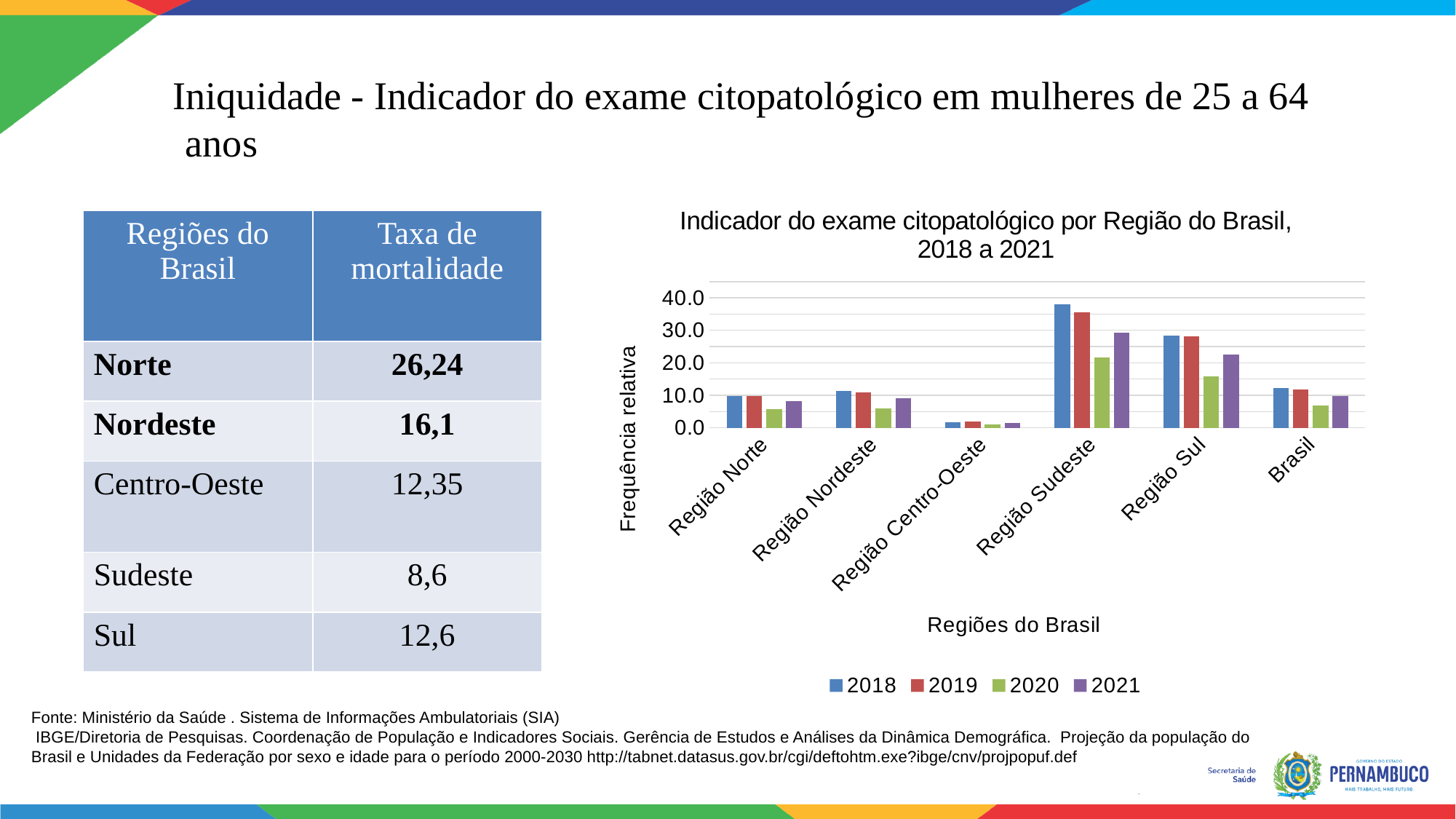
What kind of chart is shown on the slide? Bar chart Is the 2018 value for Região Norte greater or less than 20.0? less Which region has the highest value for 2018 in the chart? Região Sudeste What is the label of the chart's vertical axis? Frequência relativa Which is larger in 2018: the value for Região Sudeste or the value for Região Sul? Região Sudeste For Região Sudeste, is the 2020 value higher or lower than the 2018 value? lower For Região Sul, which year has the lowest value? 2020 Which region has the lowest value for 2018 in the chart? Região Centro-Oeste Is the 2020 value for Região Sul greater or less than 20.0? less How many series does the chart legend list? 4 How many regions (categories) are shown on the x axis of the chart? 6 Is the 2018 value for Região Sudeste greater or less than 30.0? greater